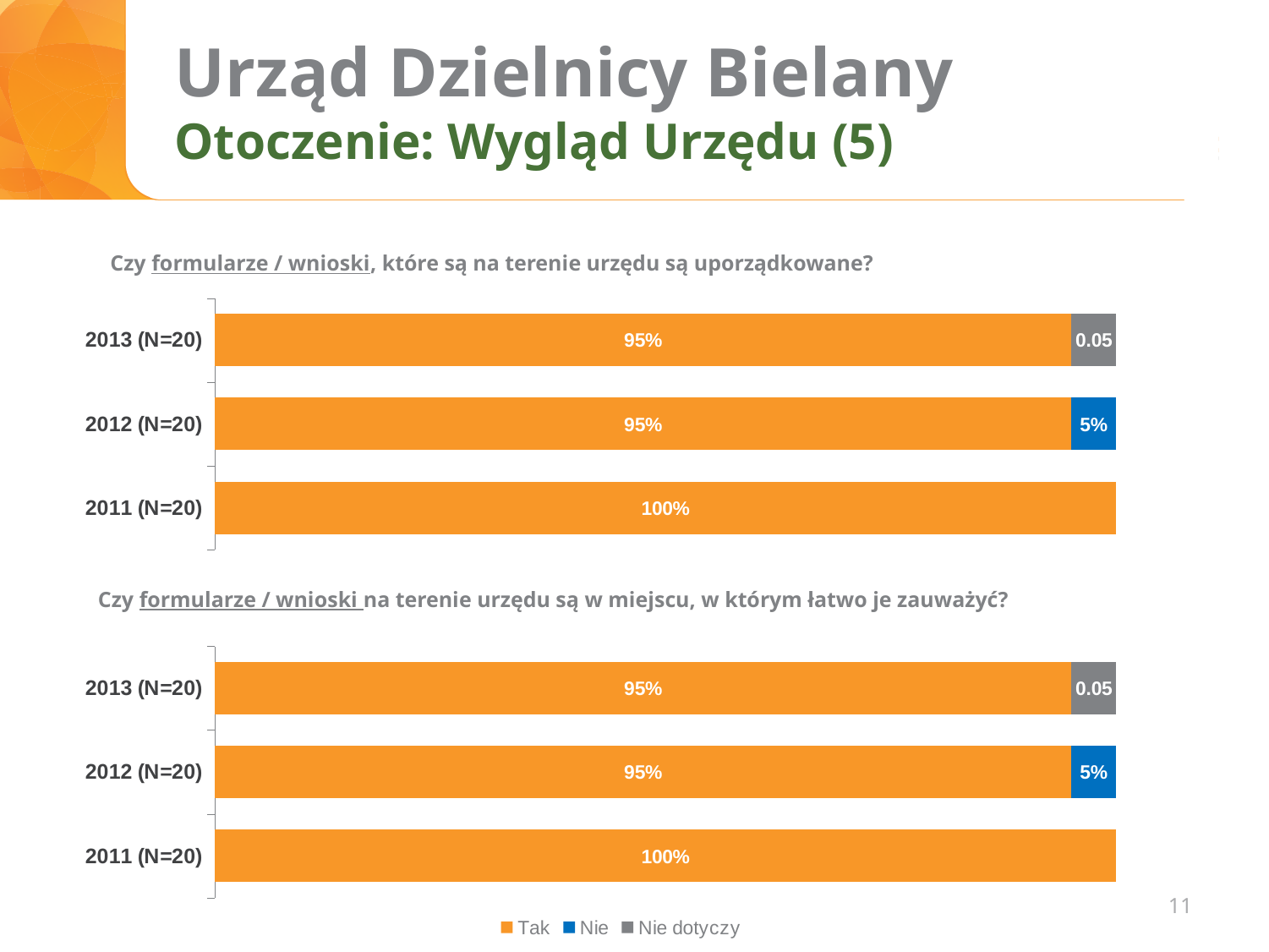
What type of chart is the bottom chart ("Czy formularze / wnioski na terenie urzędu są w miejscu, w którym łatwo je zauważyć?")? Stacked bar chart In the bottom chart ("Czy formularze / wnioski na terenie urzędu są w miejscu, w którym łatwo je zauważyć?"), what is the value for Tak in 2012 (N=20)? 95% In the top chart ("Czy formularze / wnioski, które są na terenie urzędu są uporządkowane?"), what is the difference between the Tak value for 2011 (N=20) and the Tak value for 2012 (N=20)? 5% In the bottom chart ("Czy formularze / wnioski na terenie urzędu są w miejscu, w którym łatwo je zauważyć?"), which year has the highest value for Tak? 2011 (N=20) In the top chart ("Czy formularze / wnioski, które są na terenie urzędu są uporządkowane?"), what label is printed on the Nie dotyczy segment for 2013 (N=20)? 0.05 How many year categories are shown in the top chart ("Czy formularze / wnioski, które są na terenie urzędu są uporządkowane?")? 3 In the bottom chart ("Czy formularze / wnioski na terenie urzędu są w miejscu, w którym łatwo je zauważyć?"), is the Tak value for 2011 (N=20) larger or smaller than the Tak value for 2013 (N=20)? larger In the top chart ("Czy formularze / wnioski, które są na terenie urzędu są uporządkowane?"), what is the value for Nie in 2012 (N=20)? 5% In the top chart ("Czy formularze / wnioski, które są na terenie urzędu są uporządkowane?"), what is the value for Tak in 2011 (N=20)? 100% What are the three legend entries shown at the bottom of the slide? Tak, Nie, Nie dotyczy In the top chart ("Czy formularze / wnioski, które są na terenie urzędu są uporządkowane?"), what is the value for Tak in 2013 (N=20)? 95% How many series does the legend at the bottom of the slide list? 3